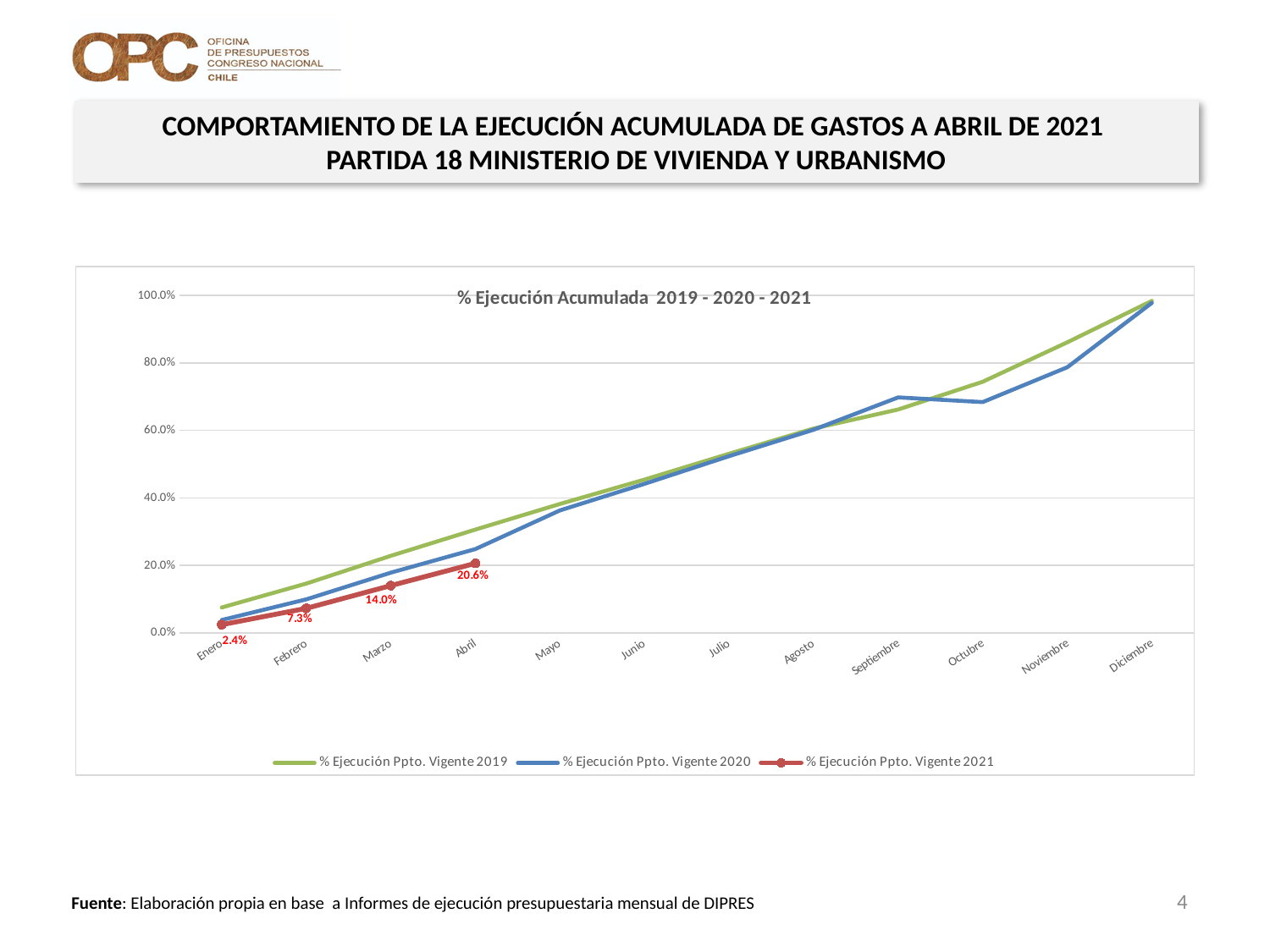
How many series does the legend list? 3 What is the value for Febrero in the % Ejecución Ppto. Vigente 2021 series? 7.3% In Octubre, which series has the larger value: % Ejecución Ppto. Vigente 2019 or % Ejecución Ppto. Vigente 2020? % Ejecución Ppto. Vigente 2019 What is the value for Enero in the % Ejecución Ppto. Vigente 2021 series? 2.4% What is the value for Abril in the % Ejecución Ppto. Vigente 2021 series? 20.6% What is the title of the chart? % Ejecución Acumulada 2019 - 2020 - 2021 Do the values of the % Ejecución Ppto. Vigente 2021 series rise or fall from Enero to Abril? Rise How many months are shown on the x axis? 12 What is the value for Marzo in the % Ejecución Ppto. Vigente 2021 series? 14.0% What is the difference between the Abril and Enero values in the % Ejecución Ppto. Vigente 2021 series? 18.2 percentage points Is the value for Octubre in the % Ejecución Ppto. Vigente 2020 series greater or less than 80%? less What kind of chart is shown on the slide? Line chart